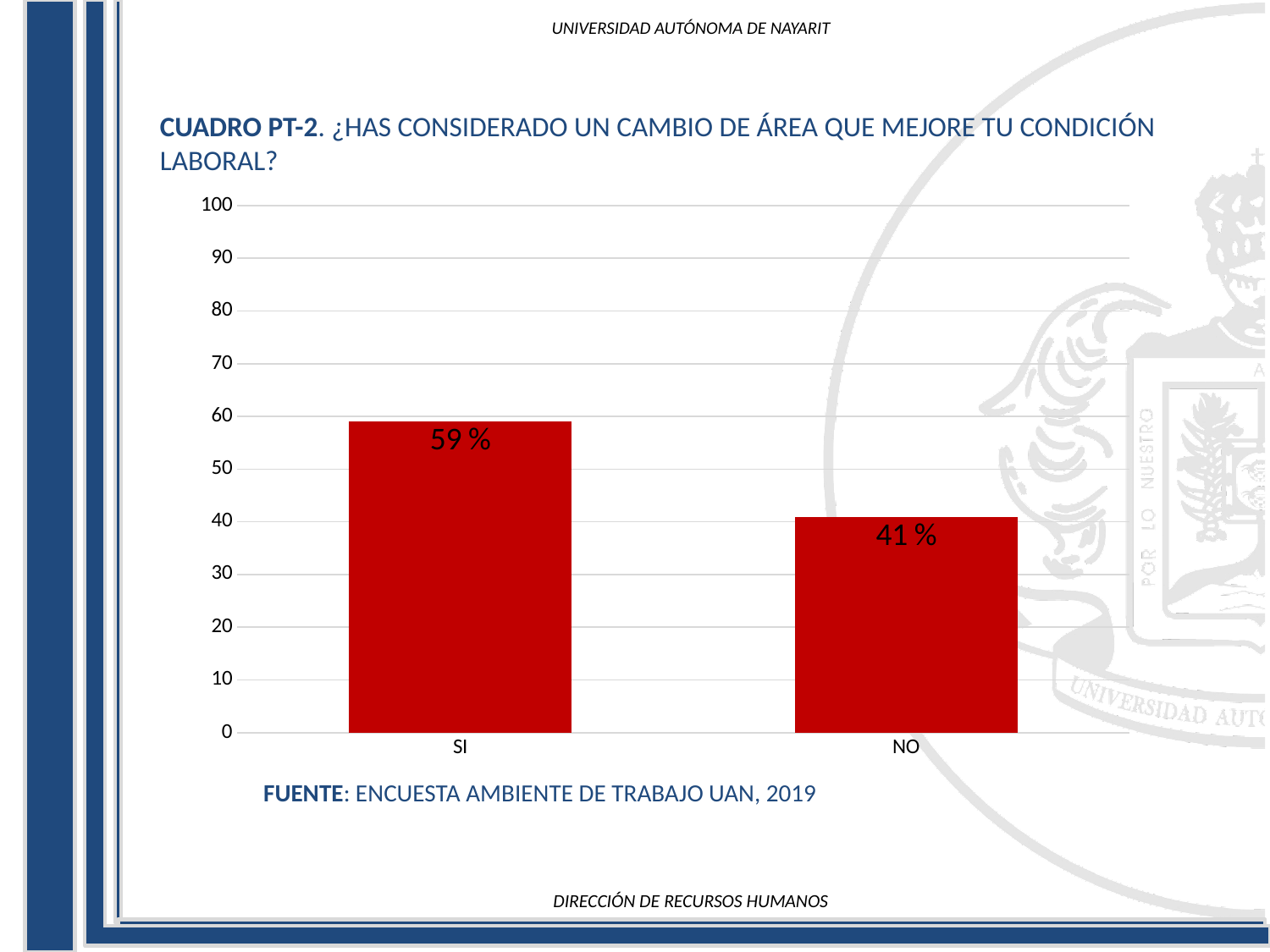
What is the value for SI? 59 % What is the value for NO? 41 % Which category has the highest value? SI What is the source cited below the chart? ENCUESTA AMBIENTE DE TRABAJO UAN, 2019 Is the value for SI greater or less than 50? greater Is the value for NO greater or less than 50? less What kind of chart is shown on the slide? bar chart What is the difference between the values for SI and NO? 18 % What is the total of the values for SI and NO? 100 % Which category has the lowest value? NO Which is larger, the value for SI or the value for NO? SI How many categories are shown on the x axis? 2